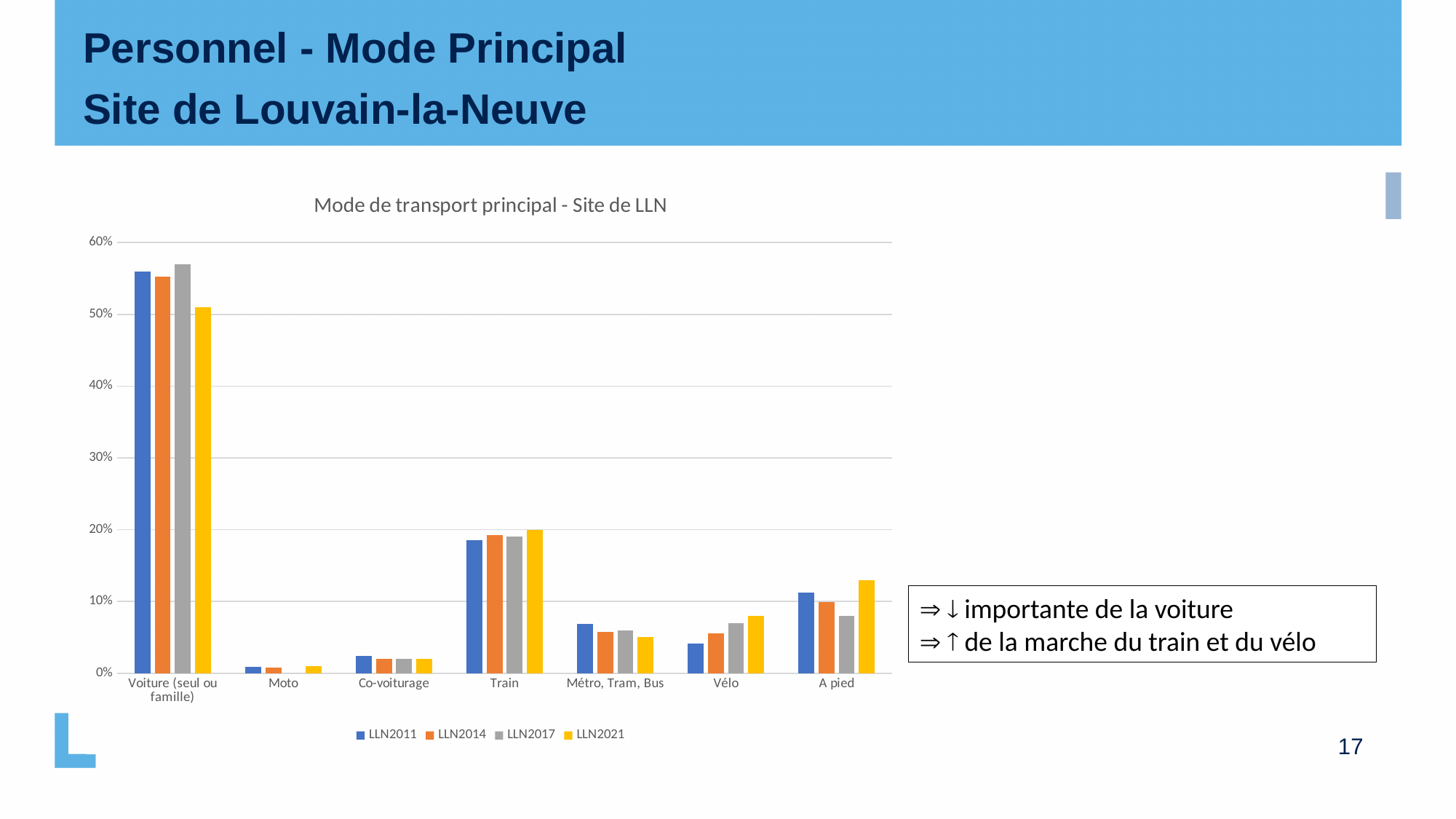
For the LLN2021 series, which is larger: Train or A pied? Train How many series does the legend list? 4 Is the LLN2021 value for A pied greater or less than 10%? greater For Vélo, do the values rise or fall from LLN2011 to LLN2021? rise What kind of chart is shown on the slide? bar chart What is the title of the chart? Mode de transport principal - Site de LLN Is the LLN2011 value for Vélo greater or less than 10%? less Which category has the lowest value for the LLN2017 series? Moto Is the LLN2021 value for Train greater or less than 30%? less Which category has the highest value for the LLN2021 series? Voiture (seul ou famille) How many transport mode categories are shown on the x axis? 7